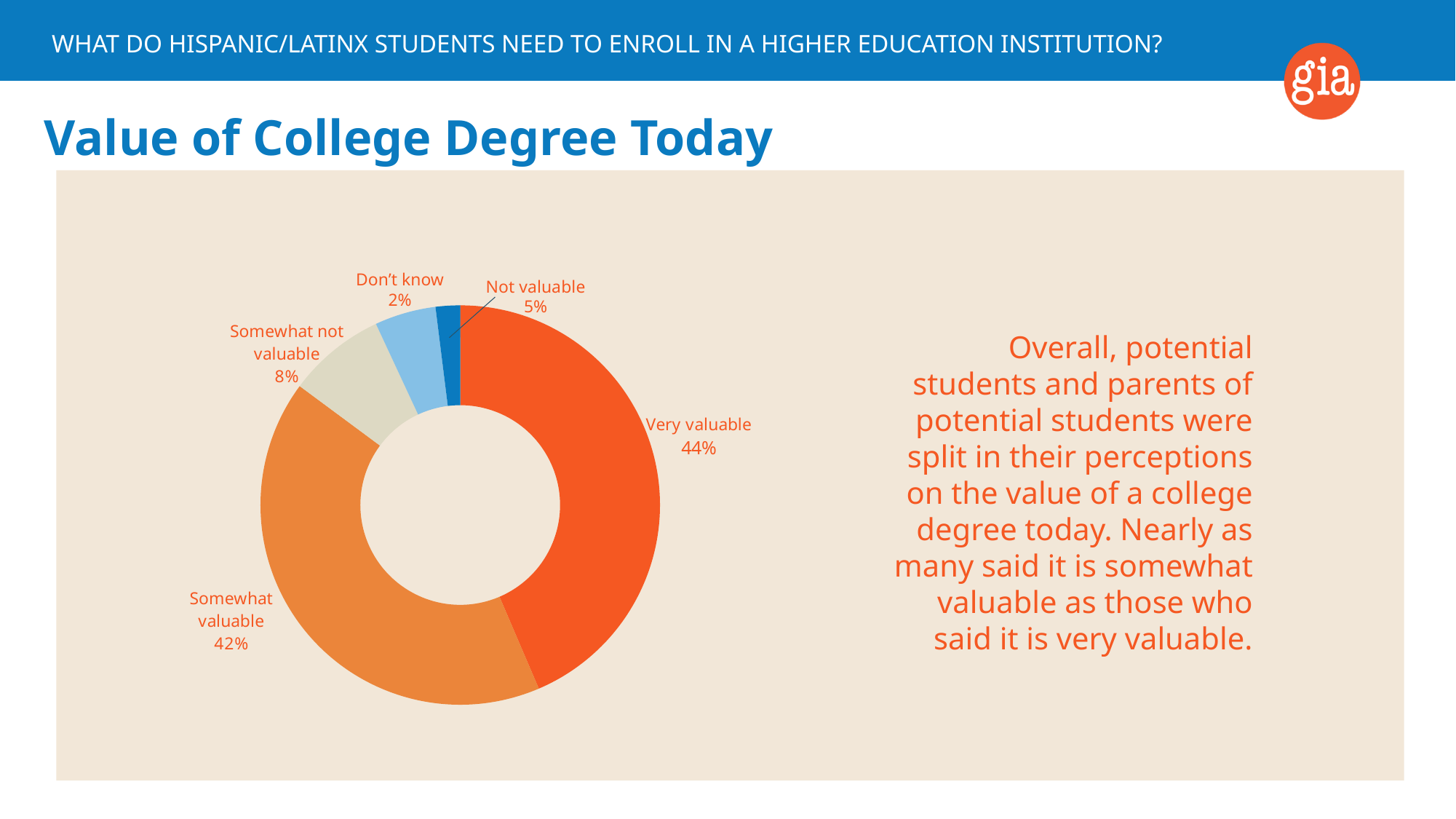
What percentage of respondents said a college degree is somewhat valuable? 42% Which is larger, the share for 'Somewhat not valuable' or the share for 'Not valuable'? Somewhat not valuable How many response categories are shown in the chart? 5 What is the title of the slide containing the chart? Value of College Degree Today What is the difference in percentage points between 'Very valuable' and 'Somewhat valuable'? 2 Which response category has the smallest share of the chart? Don't know What percentage of respondents answered 'Don't know'? 2% Which response category has the largest share of the chart? Very valuable What kind of chart is shown on the slide? Doughnut (pie) chart What percentage of respondents said a college degree is very valuable? 44% What percentage of respondents said a college degree is somewhat not valuable? 8% What percentage of respondents said a college degree is not valuable? 5%